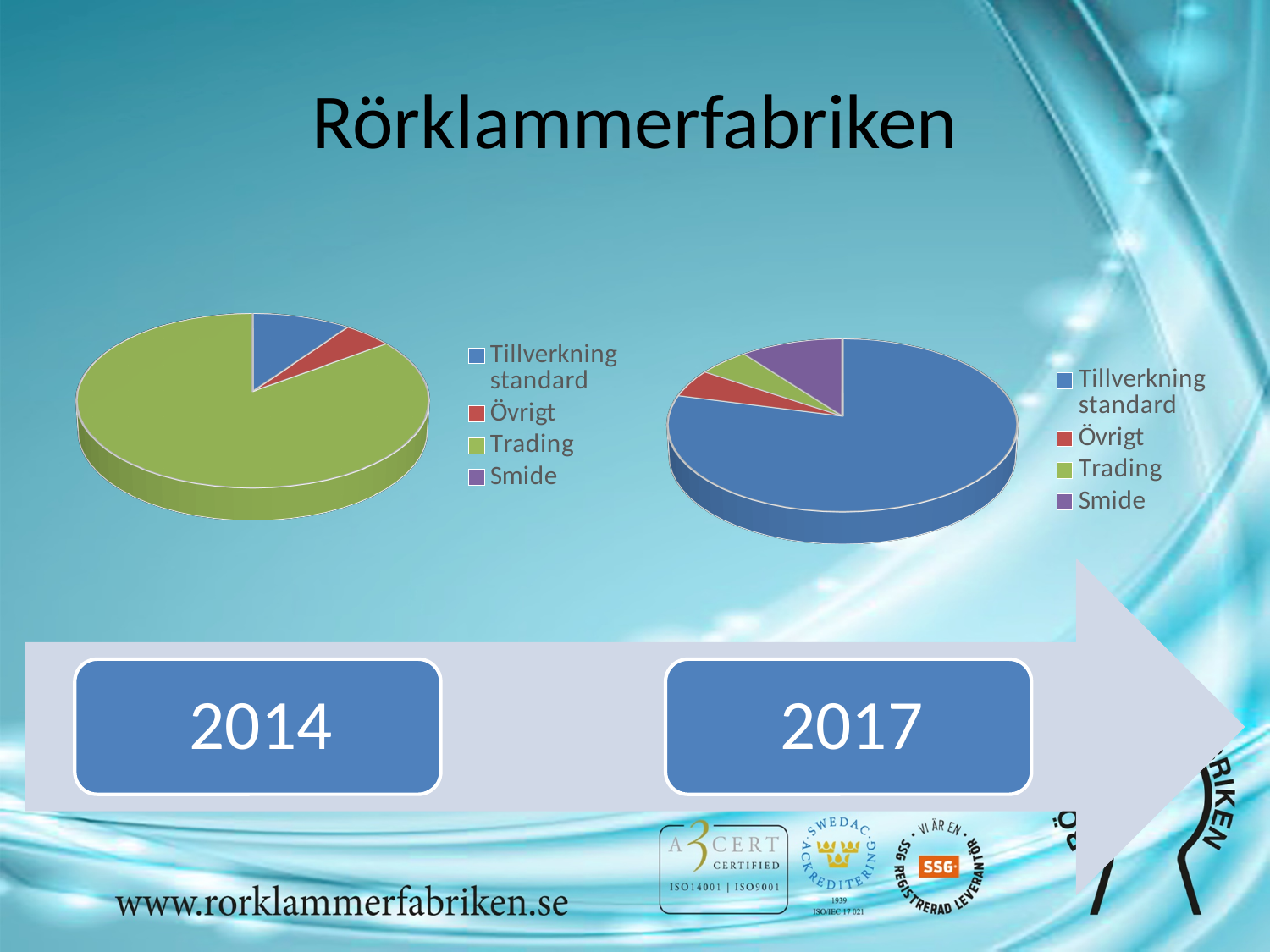
In the left pie chart (above 2014), which category has the largest slice? Trading What kind of chart is the left chart on the slide (above 2014)? pie chart How many entries does the legend of the right pie chart (above 2017) list? 4 In the right pie chart (above 2017), which is larger: the Tillverkning standard slice or the Trading slice? Tillverkning standard In the left pie chart (above 2014), which is larger: the Trading slice or the Tillverkning standard slice? Trading In the legend of the left pie chart (above 2014), which colour represents Trading? green In the right pie chart (above 2017), which is larger: the Smide slice or the Trading slice? Smide In the right pie chart (above 2017), which category has the largest slice? Tillverkning standard In the legend of the right pie chart (above 2017), which colour represents Smide? purple What kind of chart is the right chart on the slide (above 2017)? pie chart How many entries does the legend of the left pie chart (above 2014) list? 4